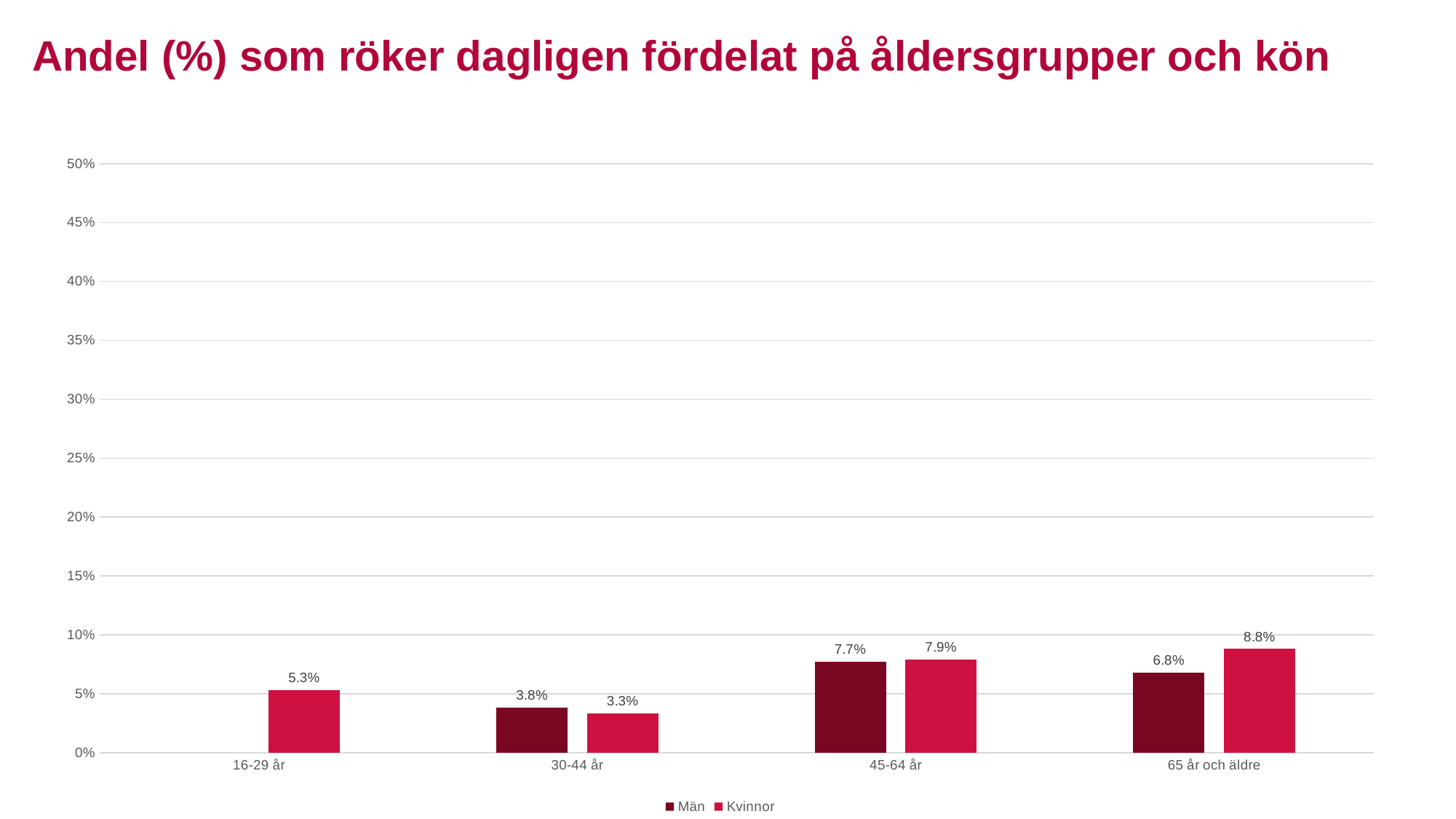
What is the value for Kvinnor in the 16-29 år age group? 5.3% What kind of chart is shown on the slide? Bar chart How many series does the legend list? 2 How many age groups are shown on the x axis? 4 What is the value for Män in the 30-44 år age group? 3.8% What is the title of the chart? Andel (%) som röker dagligen fördelat på åldersgrupper och kön Which age group has the lowest value for Män? 30-44 år What is the value for Män in the 45-64 år age group? 7.7% What is the difference between Kvinnor and Män in the 65 år och äldre age group? 2.0% What is the value for Kvinnor in the 65 år och äldre age group? 8.8% In the 30-44 år age group, which is larger, Män or Kvinnor? Män Which age group has the highest value for Kvinnor? 65 år och äldre